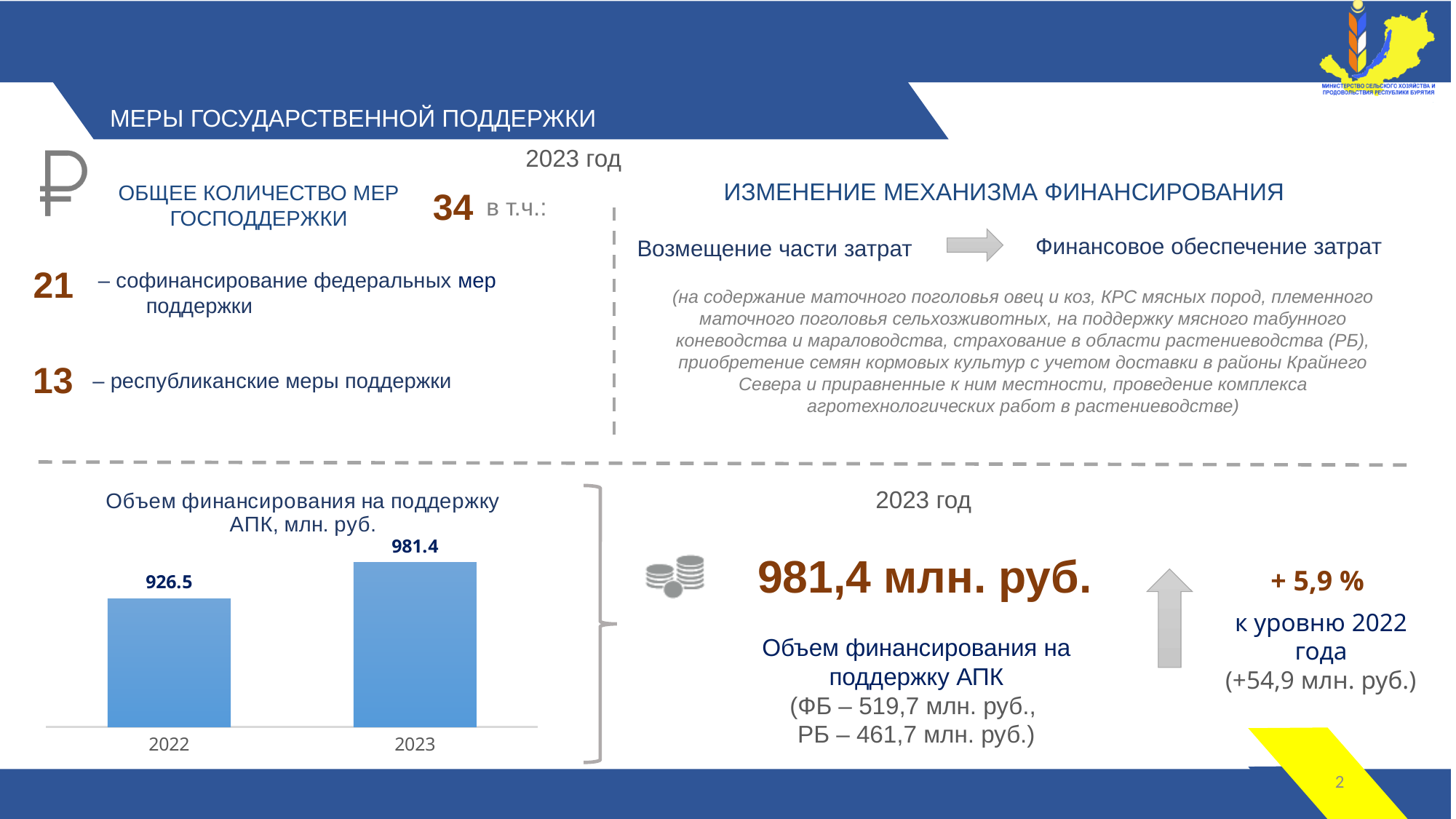
Which year has the lowest value in the chart? 2022 What is the difference between the values for 2023 and 2022 in the chart? 54.9 What is the title of the chart? Объем финансирования на поддержку АПК, млн. руб. Do the values in the chart rise or fall from 2022 to 2023? Rise What is the value for 2023 in the chart? 981.4 Which year has the highest value in the chart? 2023 Which is larger in the chart, the value for 2022 or the value for 2023? 2023 What colour are the bars in the chart? Blue How many bars are shown in the chart? 2 What is the value for 2022 in the chart? 926.5 What kind of chart is shown on the slide? Bar chart